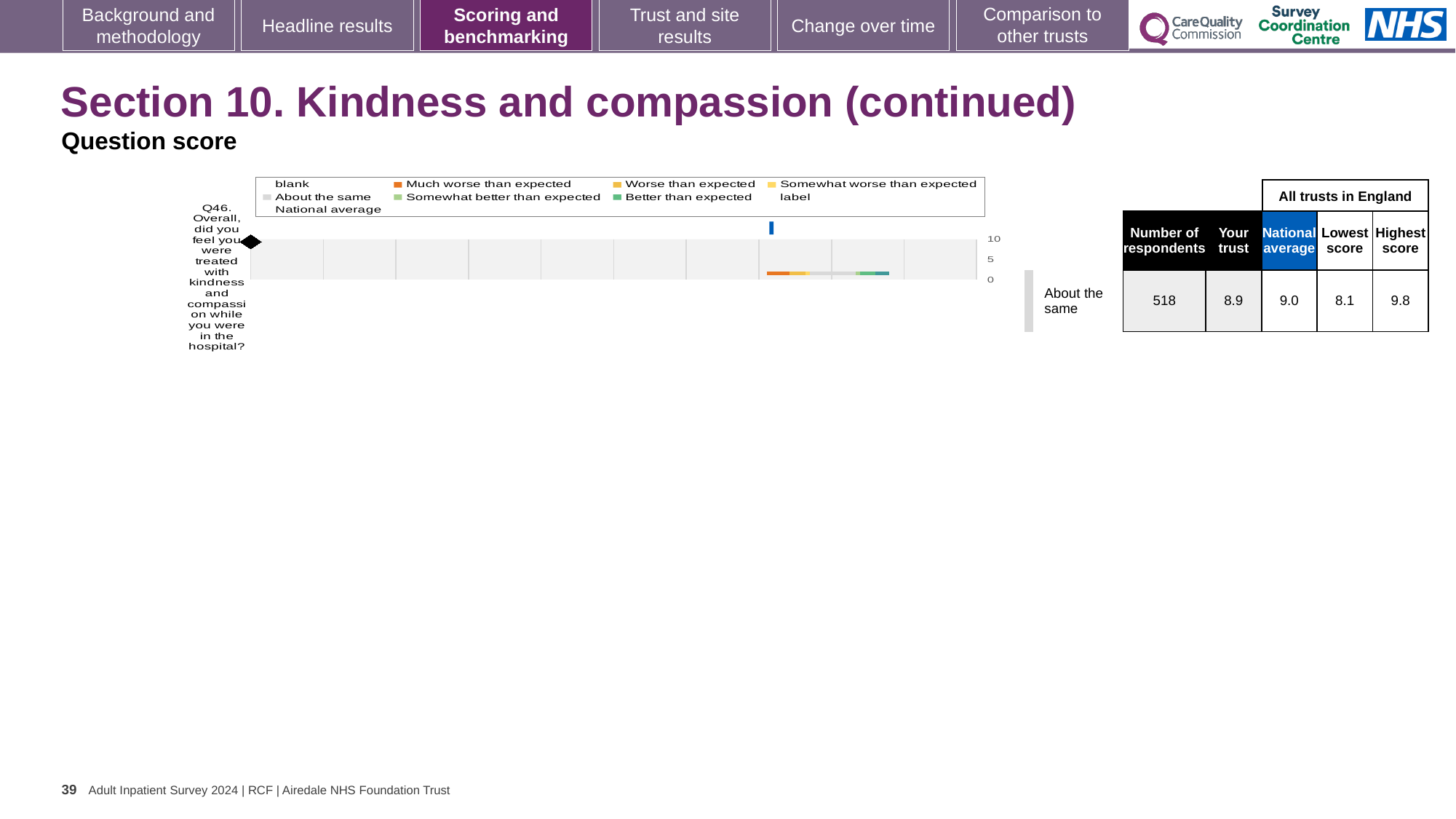
How many survey questions are plotted on the chart? 1 What is the lowest score among all trusts in England for Q46? 8.1 Which question is plotted on the chart? Q46. Overall, did you feel you were treated with kindness and compassion while you were in the hospital? Which is larger for Q46, the trust's score or the national average? national average What is the highest value shown on the chart's axis? 10 What is the highest score among all trusts in England for Q46? 9.8 What is the national average score for Q46? 9.0 What kind of chart is shown on the slide? bar chart What is the trust's score for Q46? 8.9 Which benchmarking category is the trust's Q46 score placed in? About the same How many respondents answered Q46? 518 What is the difference between the highest score and the lowest score for Q46? 1.7